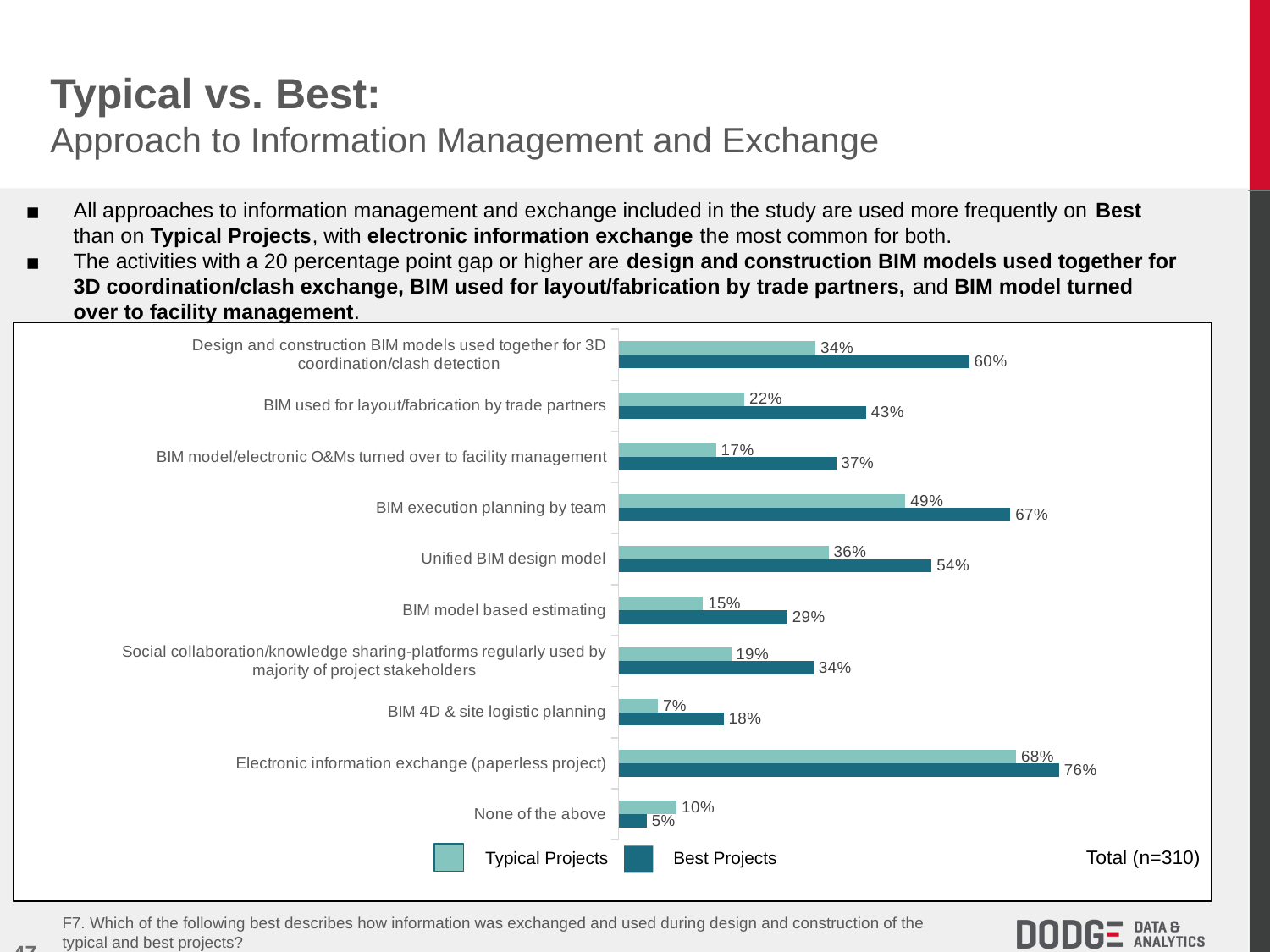
How many categories are plotted in the chart? 10 Which category has the lowest Typical Projects value? BIM 4D & site logistic planning How many series does the chart legend list? 2 What kind of chart is shown on the slide? bar chart What is the difference between the Best Projects and Typical Projects values for 'Design and construction BIM models used together for 3D coordination/clash detection'? 26 percentage points What is the difference between the Best Projects and Typical Projects values for 'BIM used for layout/fabrication by trade partners'? 21 percentage points What sample size is shown in the chart's 'Total' note? n=310 What is the Best Projects value for 'BIM model/electronic O&Ms turned over to facility management'? 37% For 'None of the above', which is larger: the Typical Projects value or the Best Projects value? Typical Projects Which category has the highest Best Projects value? Electronic information exchange (paperless project) What is the Best Projects value for 'BIM execution planning by team'? 67% What is the Typical Projects value for 'BIM 4D & site logistic planning'? 7%